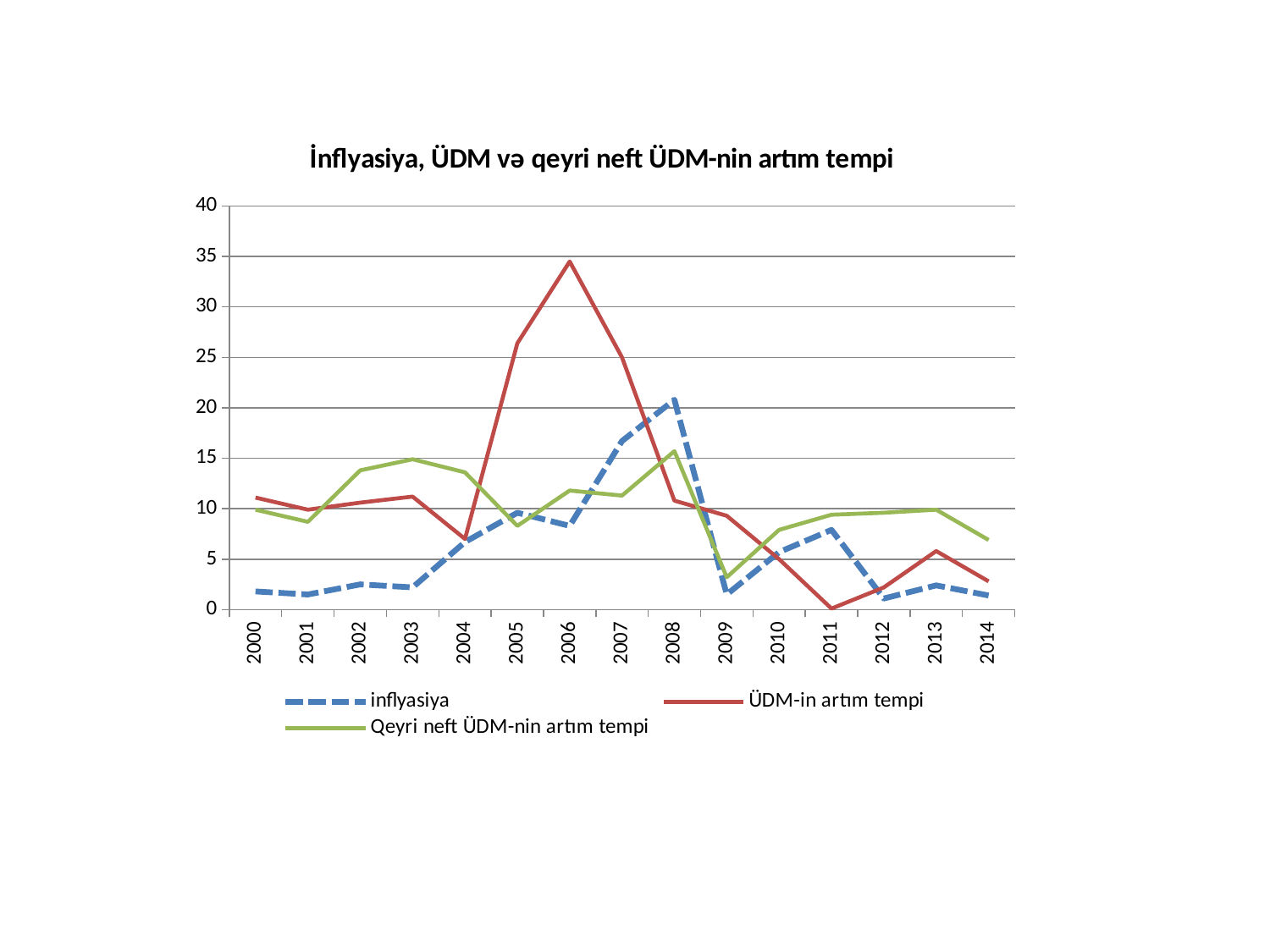
Is the value for ÜDM-in artım tempi in 2006 greater or less than 30? greater In 2006, which is larger: ÜDM-in artım tempi or inflyasiya? ÜDM-in artım tempi Is the value for inflyasiya in 2008 greater or less than 15? greater In which year is ÜDM-in artım tempi at its lowest? 2011 In 2003, which is larger: Qeyri neft ÜDM-nin artım tempi or ÜDM-in artım tempi? Qeyri neft ÜDM-nin artım tempi How many years are shown on the x axis? 15 Is the value for Qeyri neft ÜDM-nin artım tempi in 2009 greater or less than 5? less Does inflyasiya rise or fall from 2008 to 2009? fall In which year does ÜDM-in artım tempi reach its highest value? 2006 How many series does the legend list? 3 What kind of chart is shown on the slide? line chart In which year does inflyasiya reach its highest value? 2008